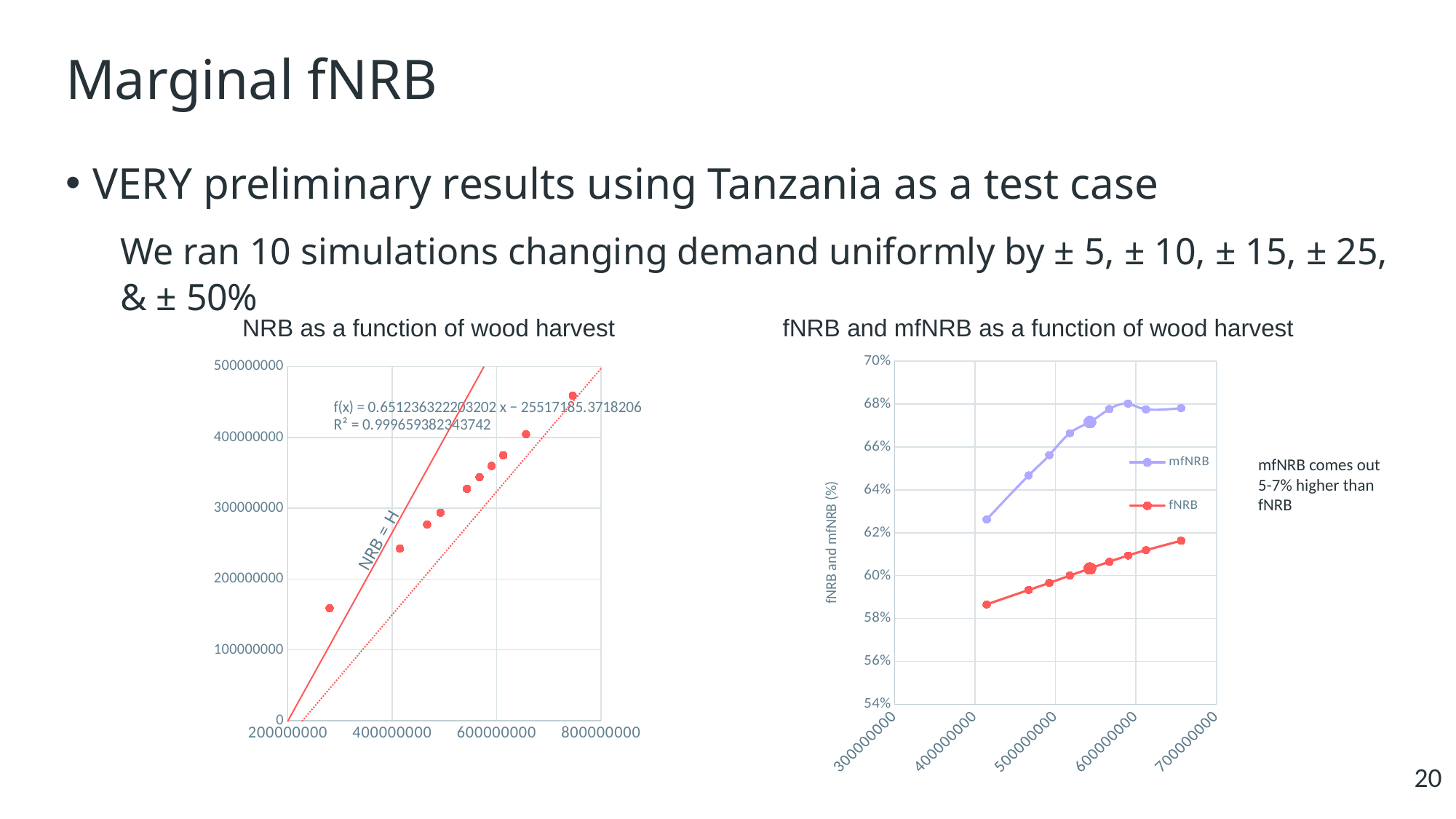
In the right chart, does the fNRB series rise or fall as wood harvest increases? rise What kind of chart is the right chart, 'fNRB and mfNRB as a function of wood harvest'? line chart What kind of chart is the left chart, 'NRB as a function of wood harvest'? scatter chart In the right chart, is the fNRB value at the highest wood harvest greater or less than 60%? greater In the left chart, is the NRB value of the leftmost point (lowest wood harvest) greater or less than 200000000? less In the left chart, what R² value is printed for the fitted trendline? 0.999659382343742 In the right chart, what is the y-axis label? fNRB and mfNRB (%) In the right chart, is the mfNRB value at the lowest wood harvest greater or less than 62%? greater In the right chart, how many series does the legend list? 2 In the right chart, which series has higher values across the wood harvest range, mfNRB or fNRB? mfNRB In the left chart, what label is written along the solid red reference line? NRB = H